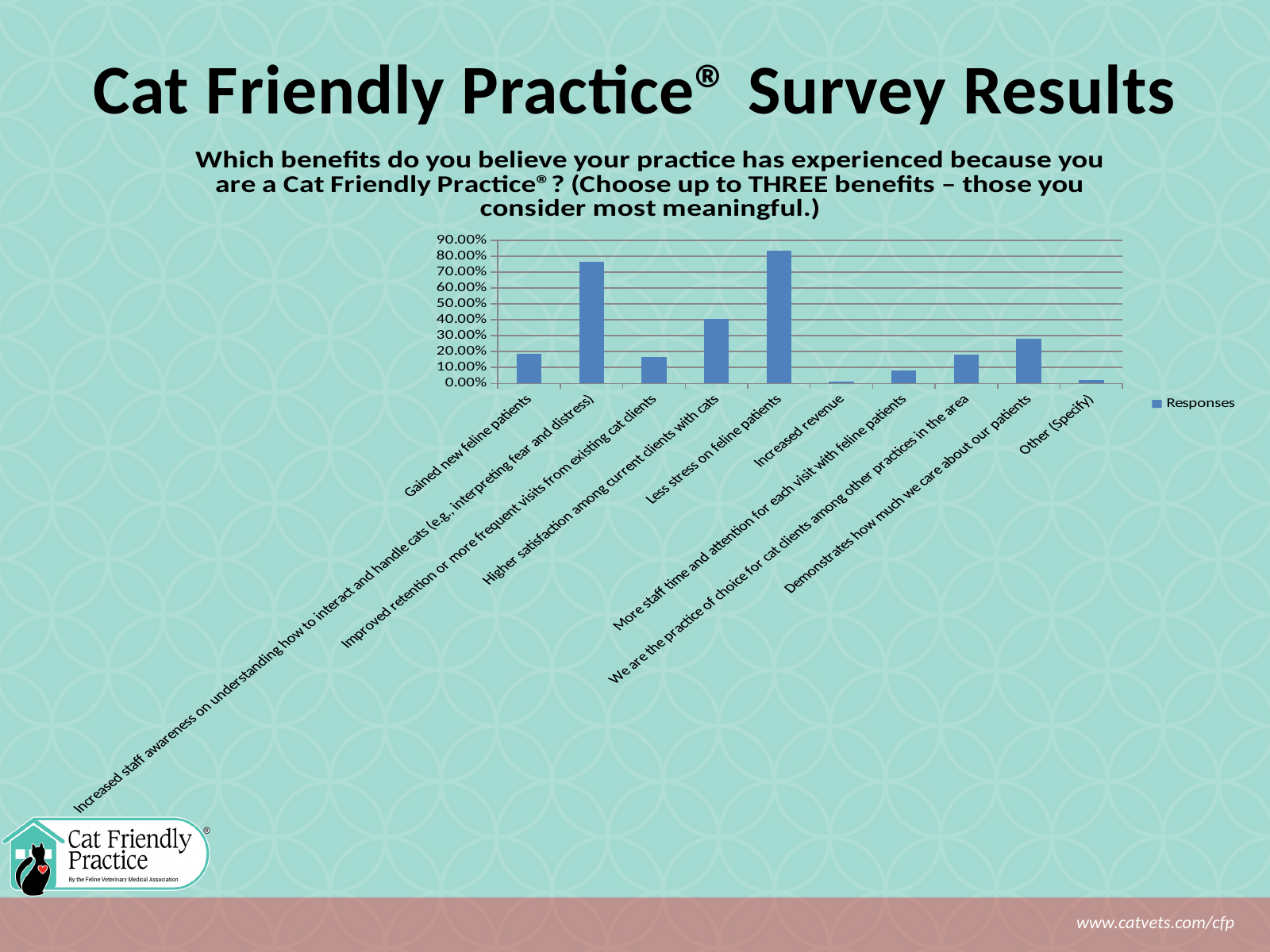
Is the value for 'Higher satisfaction among current clients with cats' greater or less than 50.00%? less Is the value for 'Increased staff awareness on understanding how to interact and handle cats' greater or less than 70.00%? greater Is the value for 'More staff time and attention for each visit with feline patients' greater or less than 10.00%? less What kind of chart is shown on the slide? bar chart How many categories (benefits) are plotted on the chart? 10 How many series does the chart legend list? 1 Which has the larger value: 'Increased staff awareness on understanding how to interact and handle cats' or 'Higher satisfaction among current clients with cats'? Increased staff awareness on understanding how to interact and handle cats Which has the larger value: 'Demonstrates how much we care about our patients' or 'Gained new feline patients'? Demonstrates how much we care about our patients Which benefit has the highest response percentage? Less stress on feline patients What is the name of the series shown in the chart legend? Responses